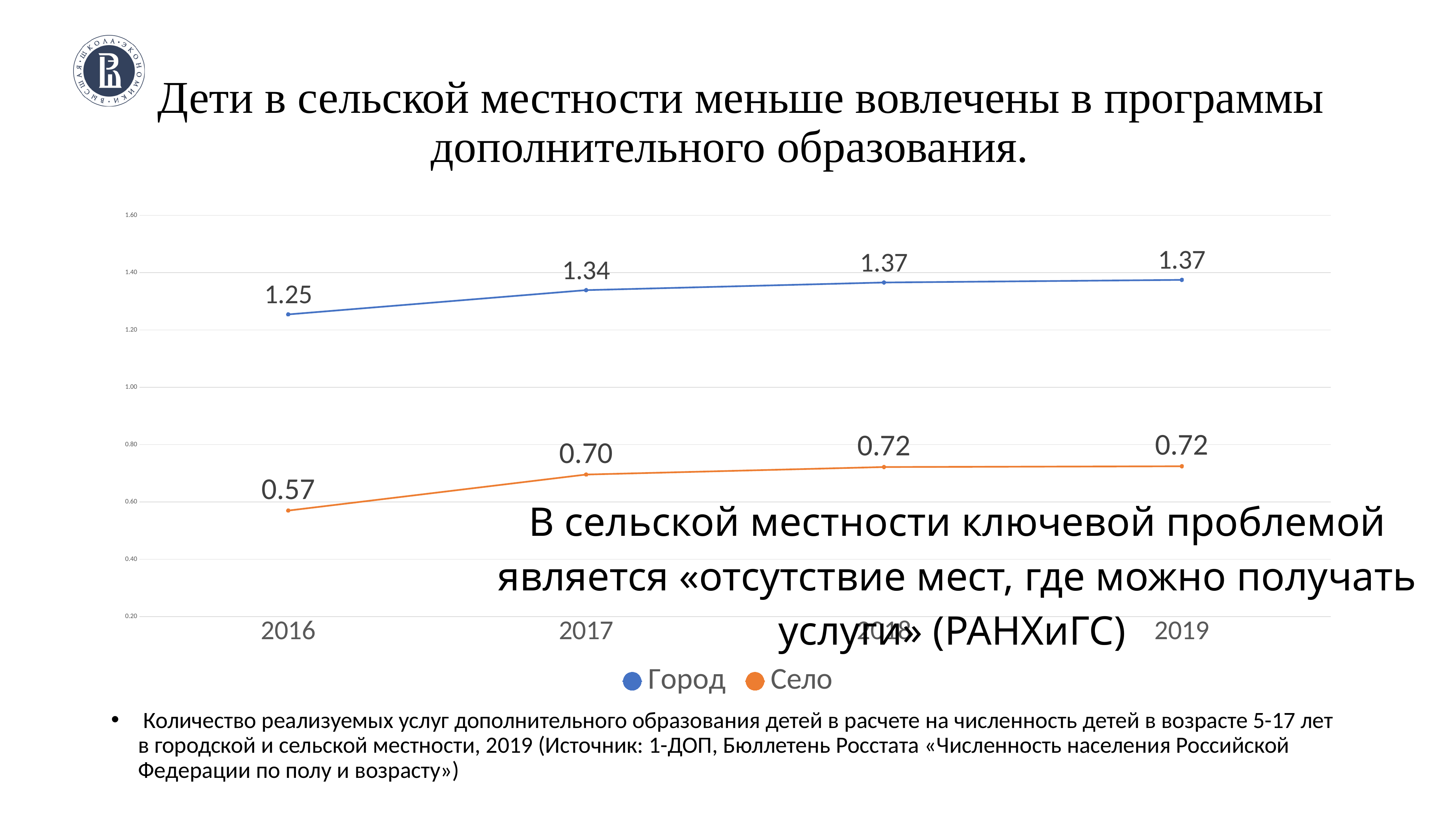
Do the values for Село rise or fall from 2016 to 2019? rise By how much did the value for Город increase from 2016 to 2017? 0.09 What is the value for Город in 2016? 1.25 What kind of chart is shown on the slide? line chart What is the value for Село in 2019? 0.72 How many years are plotted on the x axis? 4 What is the difference between the Город and Село values in 2016? 0.68 What is the value for Село in 2017? 0.70 Which series has the larger value in 2017, Город or Село? Город How many series does the legend list? 2 In which year is the value for Село lowest? 2016 What colour is the line for Село? orange